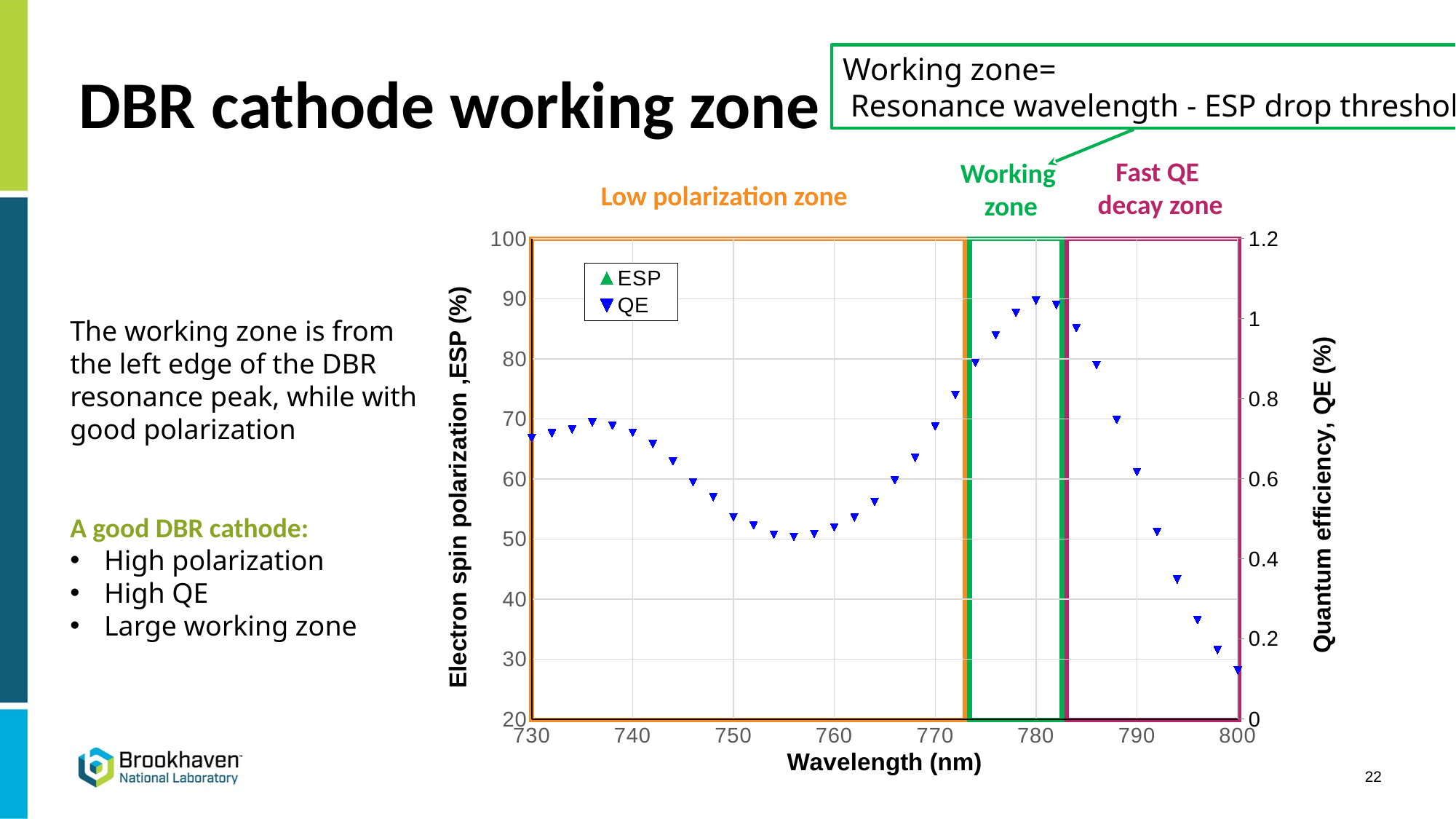
Is the QE value at 780 nm greater or less than 1? greater Is the QE value at 800 nm greater or less than 0.2? less Is the QE value at 756 nm greater or less than 0.6? less How many series does the chart legend list? 2 What kind of chart is shown on the slide? scatter chart What is the title of the x axis of the chart? Wavelength (nm) Do the QE values rise or fall as the wavelength increases from 760 nm to 780 nm? rise Do the QE values rise or fall as the wavelength increases from 790 nm to 800 nm? fall At which wavelength on the x axis is the QE value lowest? 800 Which has the larger QE value, 740 nm or 760 nm? 740 nm What are the two series named in the chart legend? ESP and QE